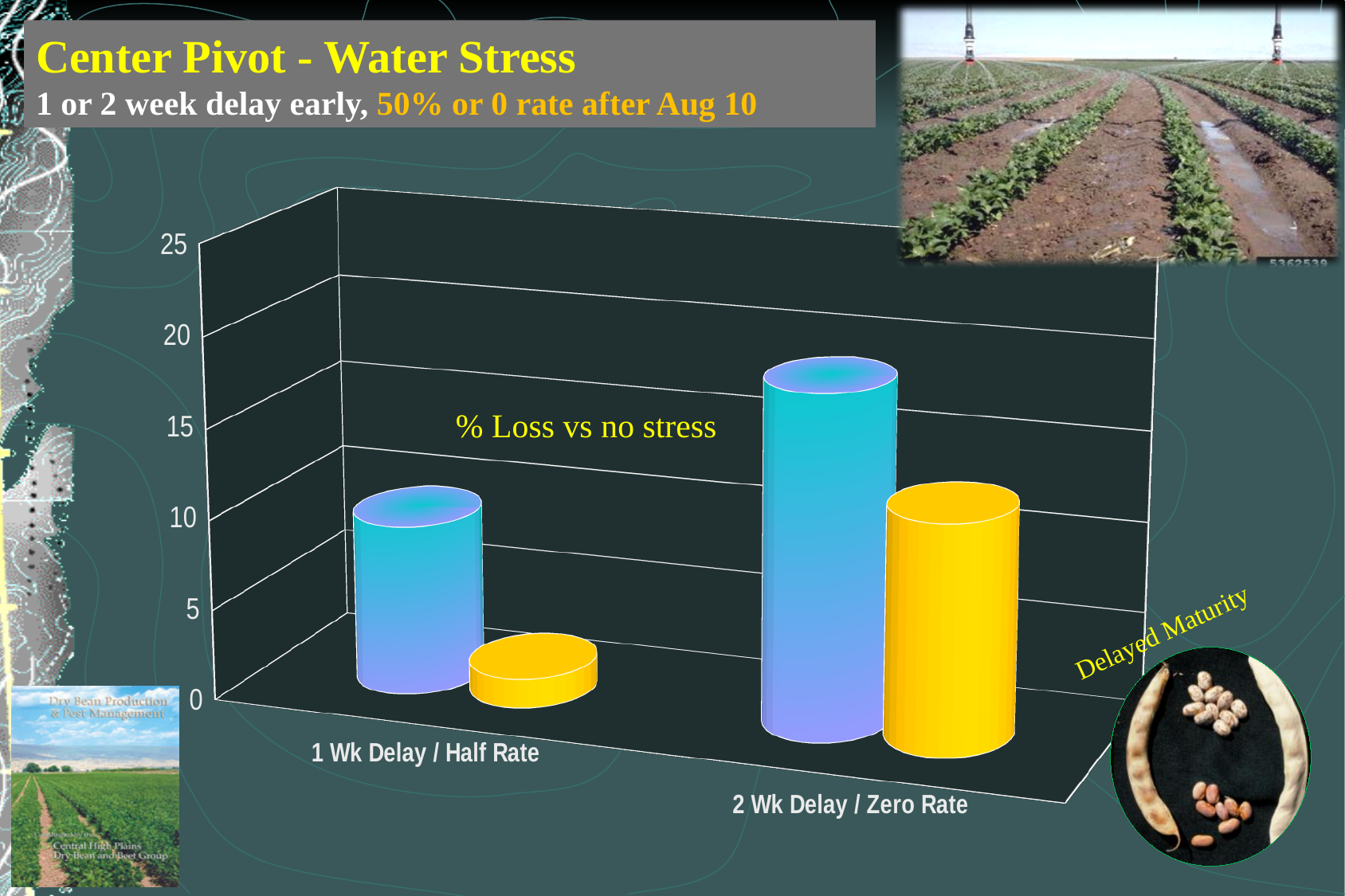
Is the value of the blue bar for 1 Wk Delay / Half Rate greater or less than 5? greater Do the bar values rise or fall from 1 Wk Delay / Half Rate to 2 Wk Delay / Zero Rate? rise What kind of chart is shown on the slide? bar chart Which category has the tallest bar in the chart? 2 Wk Delay / Zero Rate What is the highest value shown on the chart's vertical axis? 25 What text label is printed inside the chart area describing what is plotted? % Loss vs no stress Which category has the shortest bar in the chart? 1 Wk Delay / Half Rate How many categories are shown on the x axis of the chart? 2 Is the value of the yellow bar for 2 Wk Delay / Zero Rate greater or less than 5? greater Is the value of the yellow bar for 1 Wk Delay / Half Rate greater or less than 5? less Which is larger, the blue bar for 1 Wk Delay / Half Rate or the blue bar for 2 Wk Delay / Zero Rate? 2 Wk Delay / Zero Rate